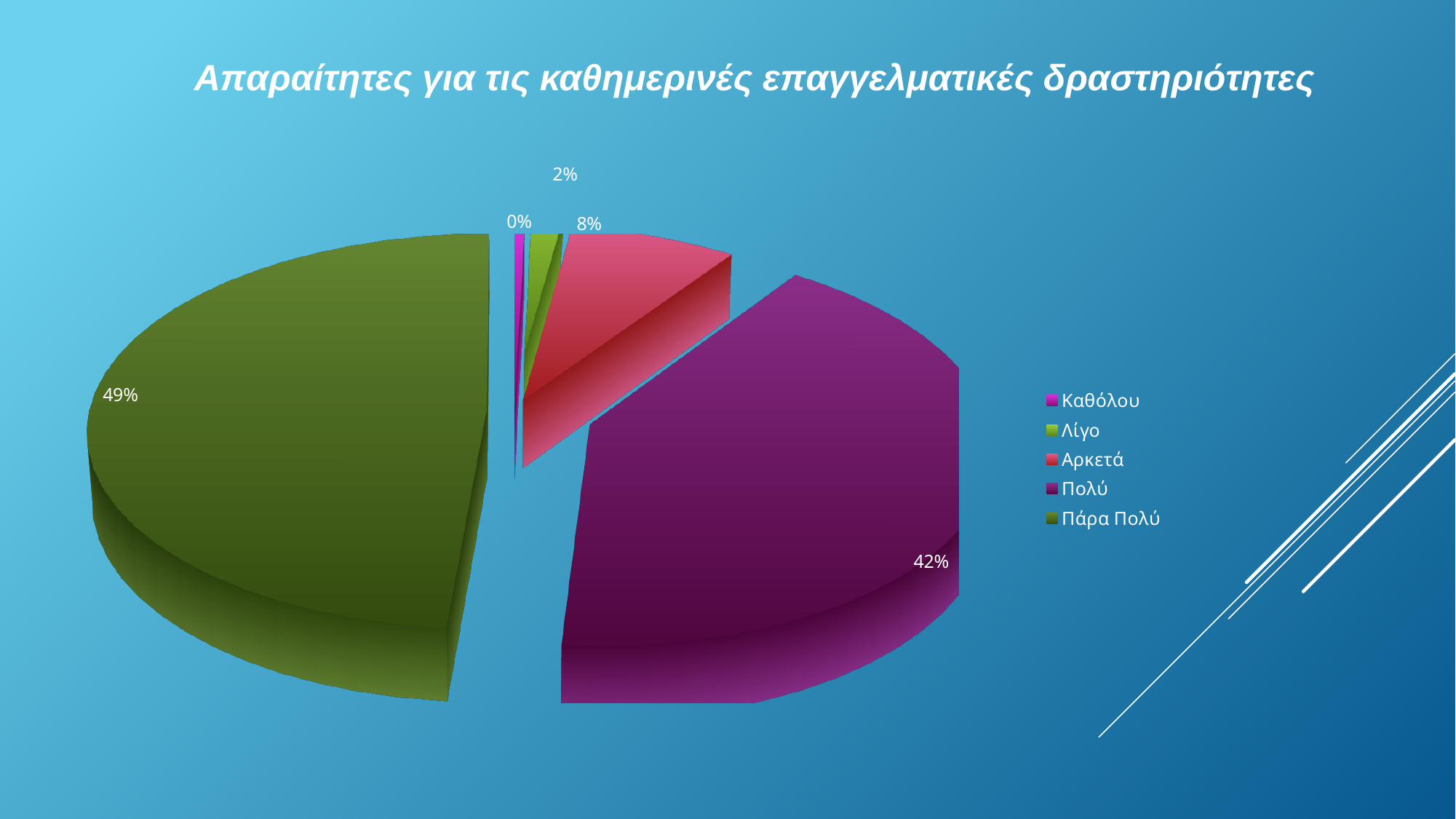
Which category has the largest slice? Πάρα Πολύ What share of the pie does Πάρα Πολύ have? 49% What share of the pie does Καθόλου have? 0% Which is larger, the share for Αρκετά or the share for Λίγο? Αρκετά What share of the pie does Λίγο have? 2% What kind of chart is shown on the slide? pie chart How many categories does the legend list? 5 What is the title of the chart? Απαραίτητες για τις καθημερινές επαγγελματικές δραστηριότητες What is the difference between the shares of Πάρα Πολύ and Πολύ? 7% Which category has the smallest slice? Καθόλου